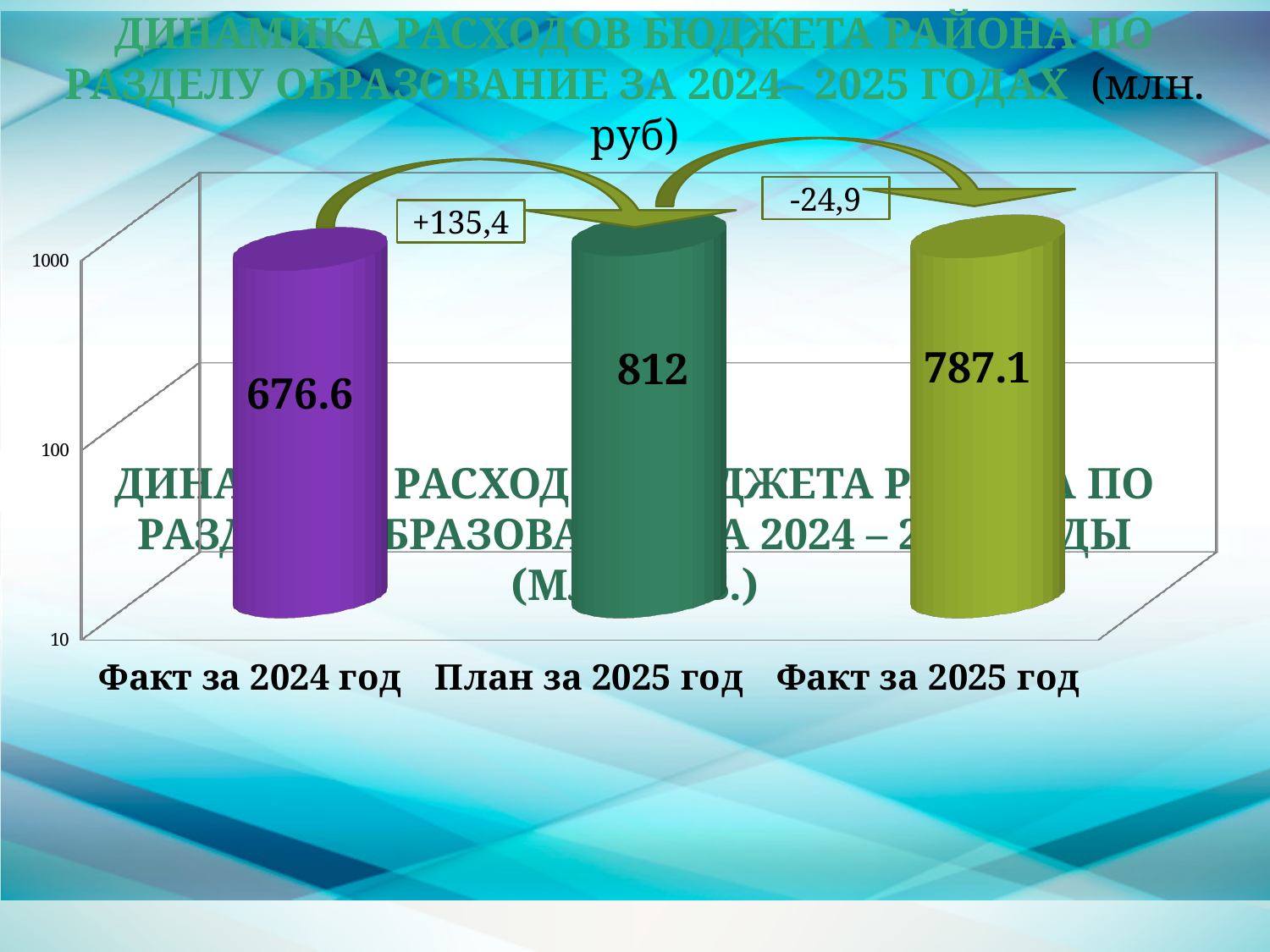
Is the value for План за 2025 год greater or less than 1000? less Which is larger, Факт за 2025 год or Факт за 2024 год? Факт за 2025 год What kind of chart is shown on the slide? bar chart What is the difference between План за 2025 год and Факт за 2025 год? 24.9 How many categories are shown in the chart? 3 What is the difference between План за 2025 год and Факт за 2024 год? 135.4 What is the value for План за 2025 год? 812 Which category has the highest value? План за 2025 год Which category has the lowest value? Факт за 2024 год What is the value for Факт за 2024 год? 676.6 What change is shown in the annotation between Факт за 2024 год and План за 2025 год? +135,4 What is the value for Факт за 2025 год? 787.1